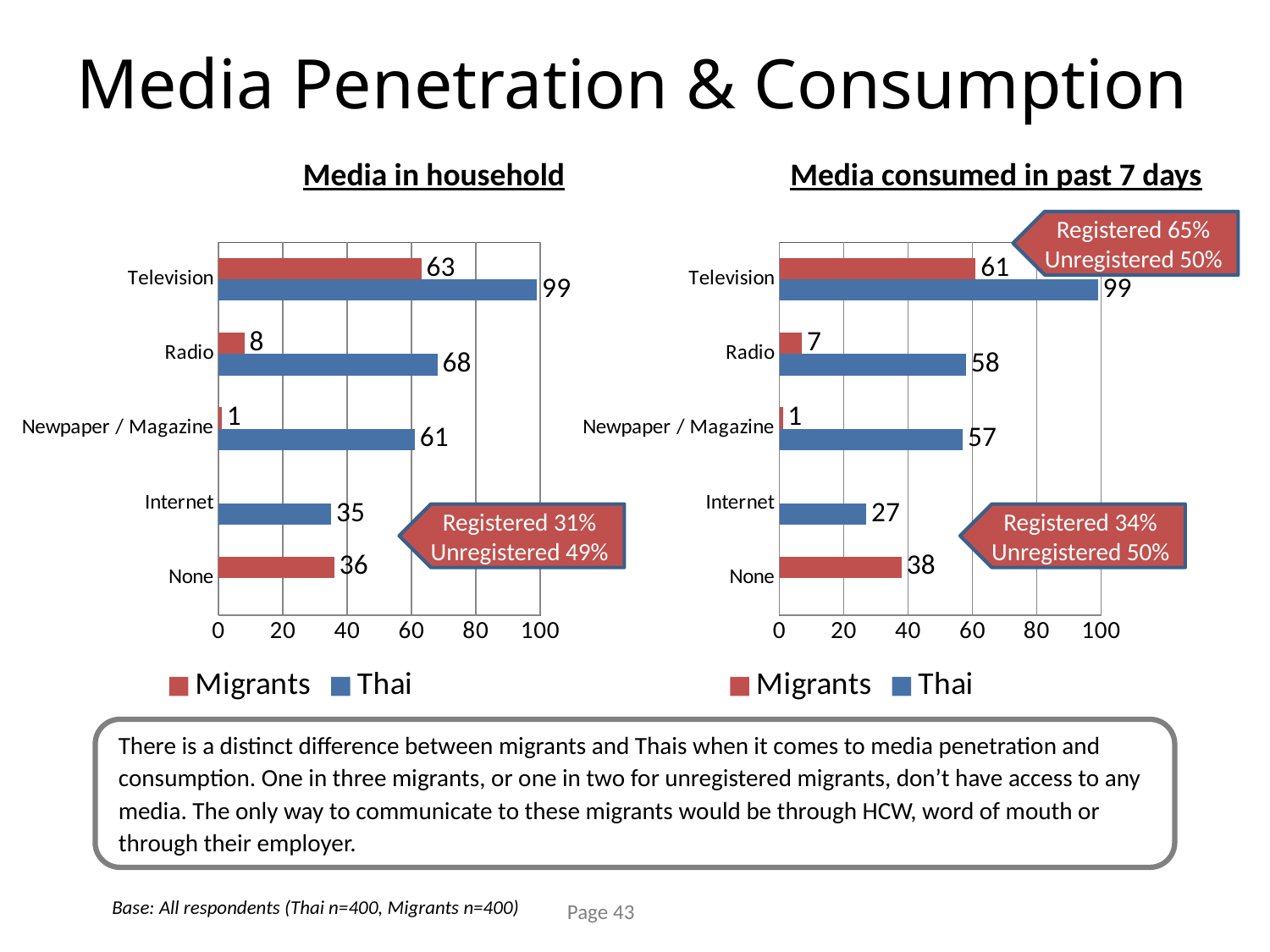
In the 'Media consumed in past 7 days' chart, what is the value for Thai for Internet? 27 In the 'Media consumed in past 7 days' chart, what is the value for Migrants for Television? 61 In the 'Media consumed in past 7 days' chart, which category has the highest Thai value? Television How many series does the legend of the 'Media consumed in past 7 days' chart list? 2 In the 'Media in household' chart, what is the difference between the Thai and Migrants values for Television? 36 How many categories are shown on the y axis of the 'Media in household' chart? 5 In the 'Media in household' chart, what is the value for Migrants for Radio? 8 In the 'Media in household' chart, is the Thai value for Radio larger than the Thai value for Newpaper / Magazine? Yes In the 'Media in household' chart, what is the value for Thai for Television? 99 In the 'Media consumed in past 7 days' chart, what is the difference between the Thai and Migrants values for Radio? 51 What type of chart is the 'Media consumed in past 7 days' chart? Bar chart In the 'Media in household' chart, which category has the lowest Migrants value? Newpaper / Magazine